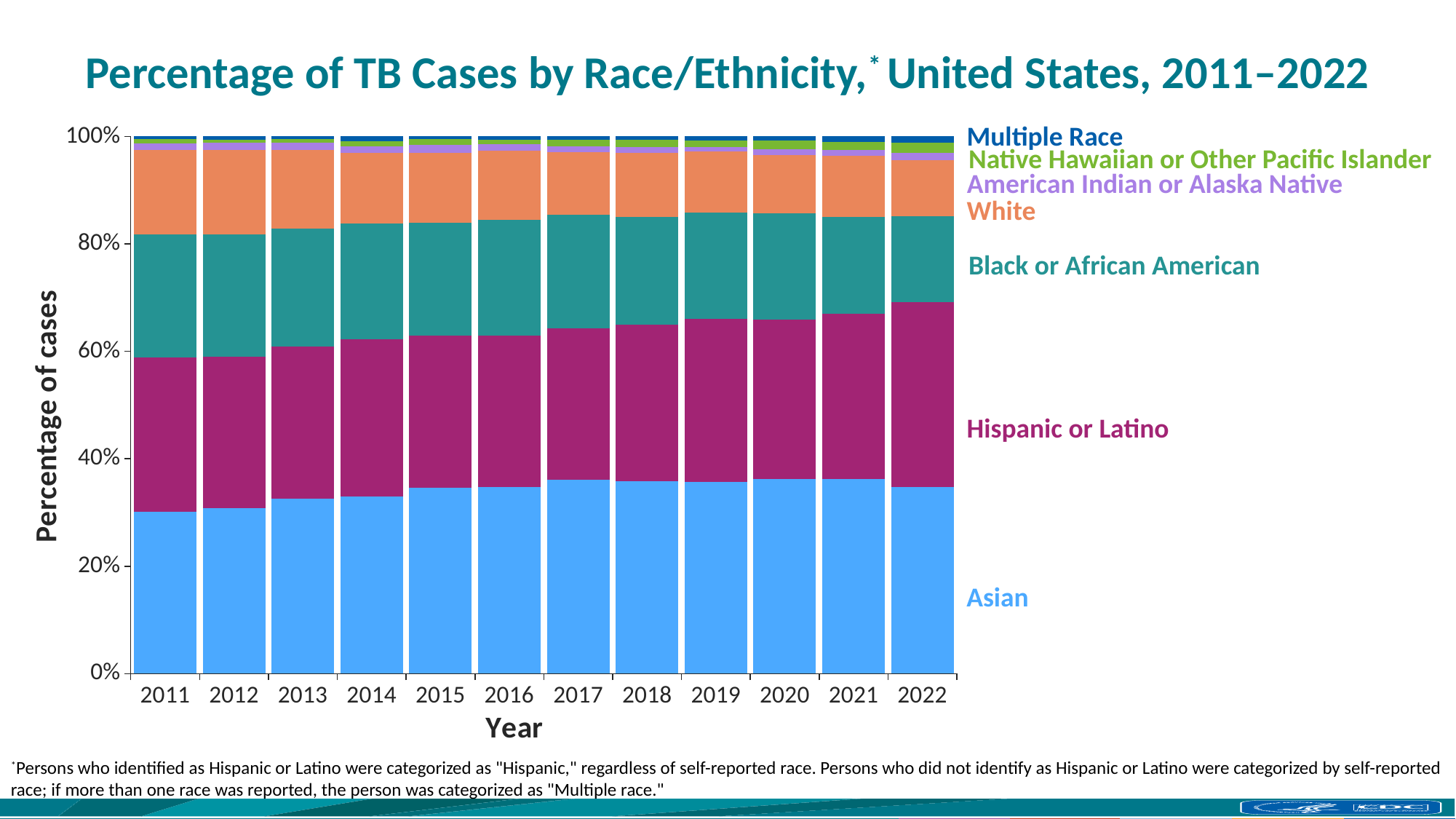
What is the total of the stacked bar for 2015? 100% Is the Asian share of TB cases in 2011 greater or less than 40%? less What is the label on the y axis? Percentage of cases How many race/ethnicity groups does the legend list? 7 How many years are shown along the x axis? 12 Does the Hispanic or Latino share of TB cases rise or fall from 2011 to 2022? rise In 2022, which segment is larger: Black or African American or White? Black or African American Is the Asian share of TB cases in 2017 greater or less than 30%? greater In 2011, which segment is larger: Black or African American or White? Black or African American Is the Asian share of TB cases in 2020 greater or less than 20%? greater What kind of chart is shown on the slide? Stacked bar chart Does the Black or African American share of TB cases rise or fall from 2011 to 2022? fall